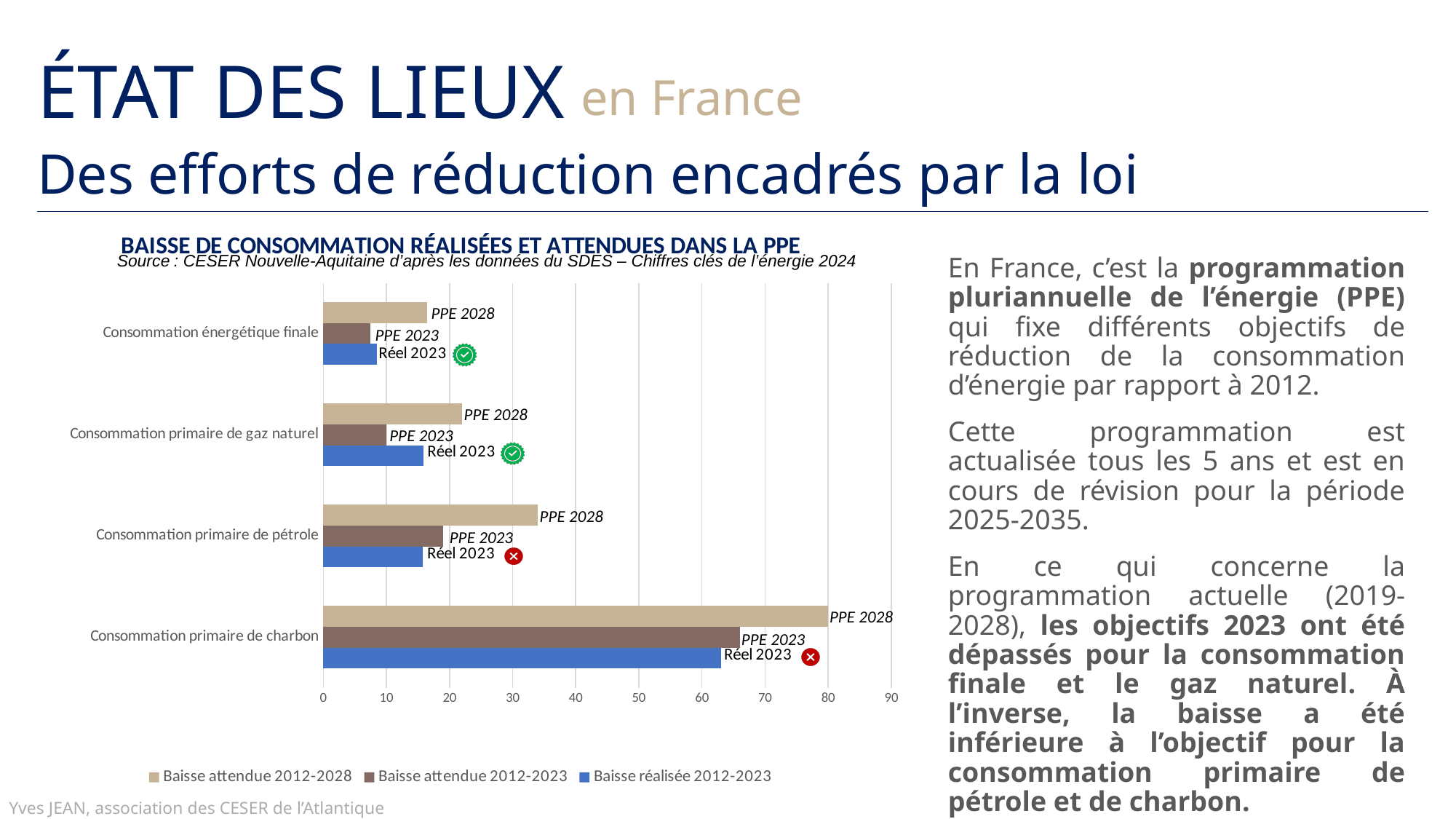
What kind of chart is shown on the slide? Bar chart Is the PPE 2028 value for Consommation primaire de pétrole greater or less than 30? greater What is the title of the chart? BAISSE DE CONSOMMATION RÉALISÉES ET ATTENDUES DANS LA PPE Is the PPE 2028 value for Consommation primaire de charbon greater or less than 70? greater For Consommation primaire de pétrole, which is larger: the PPE 2023 bar or the Réel 2023 bar? PPE 2023 Is the PPE 2028 value for Consommation énergétique finale greater or less than 20? less Which category has the highest value for Baisse attendue 2012-2028 (PPE 2028)? Consommation primaire de charbon Which category has the lowest value for Baisse attendue 2012-2028 (PPE 2028)? Consommation énergétique finale For Consommation primaire de gaz naturel, which is larger: the Réel 2023 bar or the PPE 2023 bar? Réel 2023 How many series does the chart legend list? 3 How many categories are shown on the chart? 4